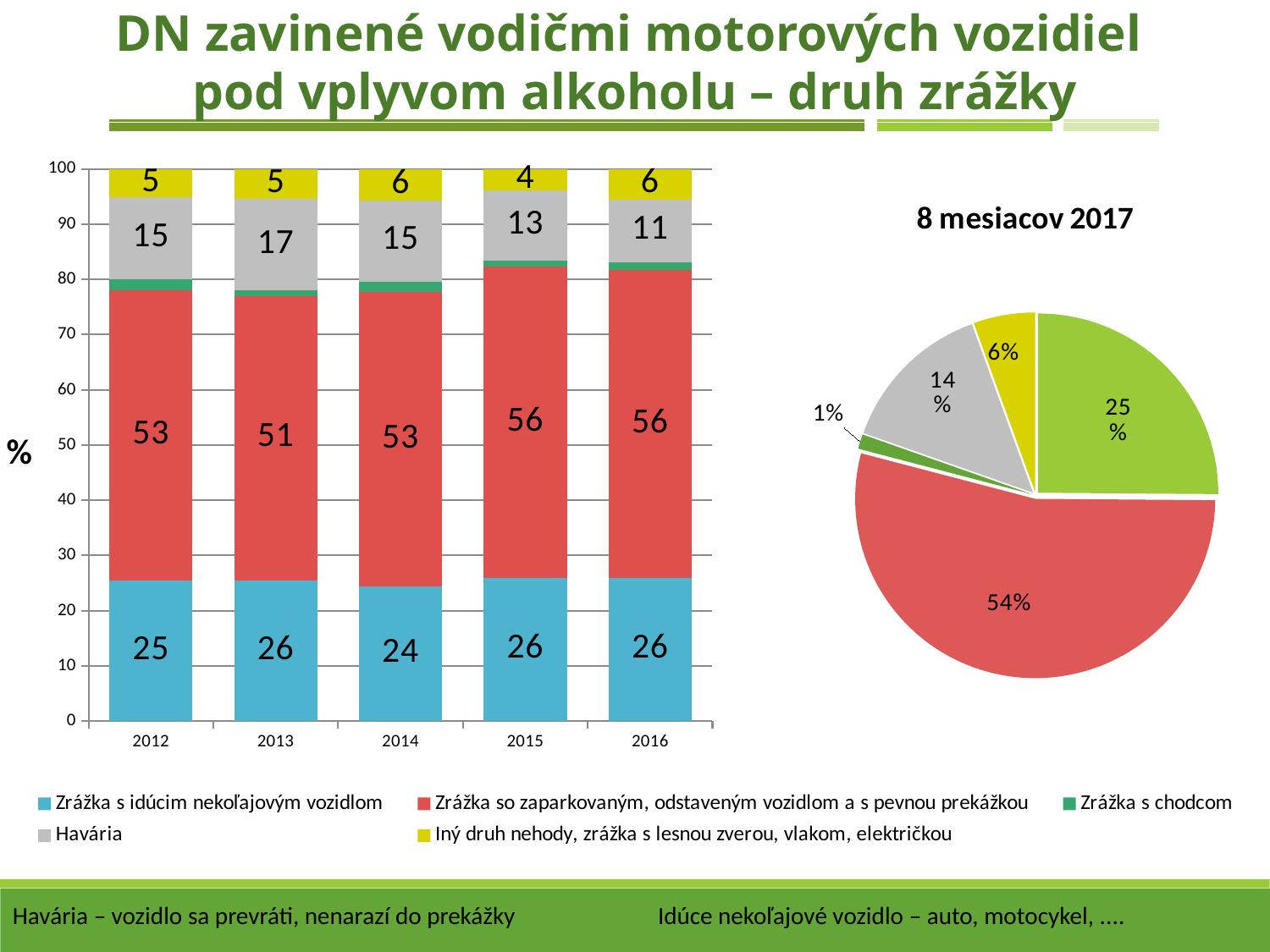
What kind of chart is the chart on the left of the slide? Stacked bar chart In the stacked bar chart on the left, what is the value for 'Zrážka so zaparkovaným, odstaveným vozidlom a s pevnou prekážkou' in 2015? 56 In the stacked bar chart on the left, what is the value for 'Havária' in 2013? 17 In the stacked bar chart on the left, what is the difference between the 'Havária' values for 2013 and 2016? 6 In the pie chart titled '8 mesiacov 2017', what share does the largest slice have? 54% In the pie chart titled '8 mesiacov 2017', what share does the grey slice have? 14% In the stacked bar chart on the left, is the 'Zrážka so zaparkovaným, odstaveným vozidlom a s pevnou prekážkou' value larger in 2013 or in 2016? 2016 In the stacked bar chart on the left, what is the value for 'Zrážka s idúcim nekoľajovým vozidlom' in 2014? 24 How many years are shown on the x axis of the stacked bar chart on the left? 5 In the stacked bar chart on the left, which year has the highest value for 'Havária'? 2013 How many series does the legend of the stacked bar chart list? 5 In the stacked bar chart on the left, which year has the lowest value for 'Iný druh nehody, zrážka s lesnou zverou, vlakom, električkou'? 2015